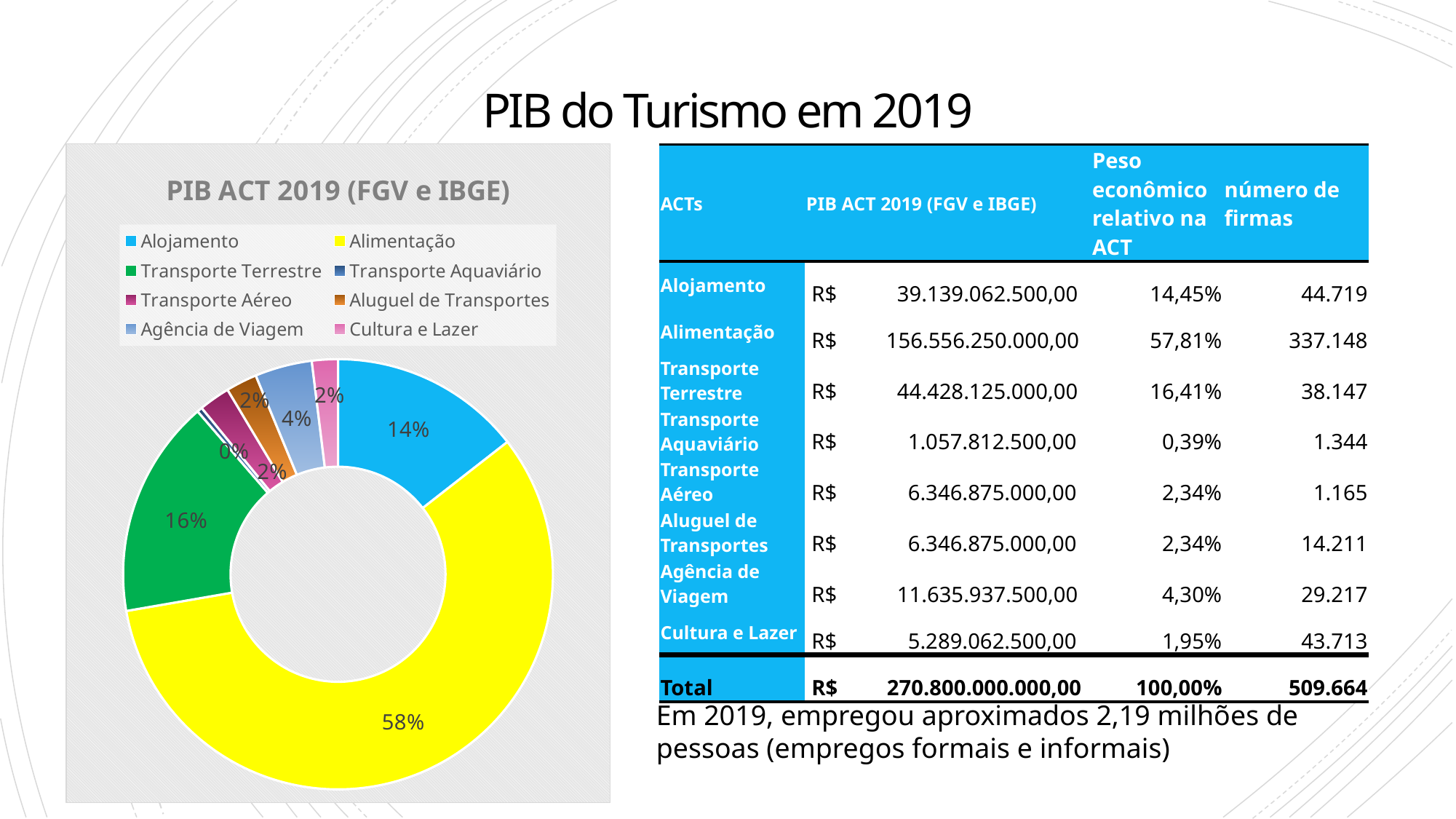
What share of the chart does Alimentação represent? 58% What is the title of the chart? PIB ACT 2019 (FGV e IBGE) What kind of chart is shown on the slide? doughnut chart What is the difference between the shares of Alimentação and Alojamento? 44% What is the value shown for Alojamento in the chart? 14% Which category has the smallest share in the chart? Transporte Aquaviário What is the value shown for Agência de Viagem in the chart? 4% Which has a larger share, Transporte Terrestre or Alojamento? Transporte Terrestre What is the value shown for Transporte Aquaviário in the chart? 0% What is the value shown for Transporte Terrestre in the chart? 16% How many categories does the chart show? 8 Which category has the largest share in the chart? Alimentação